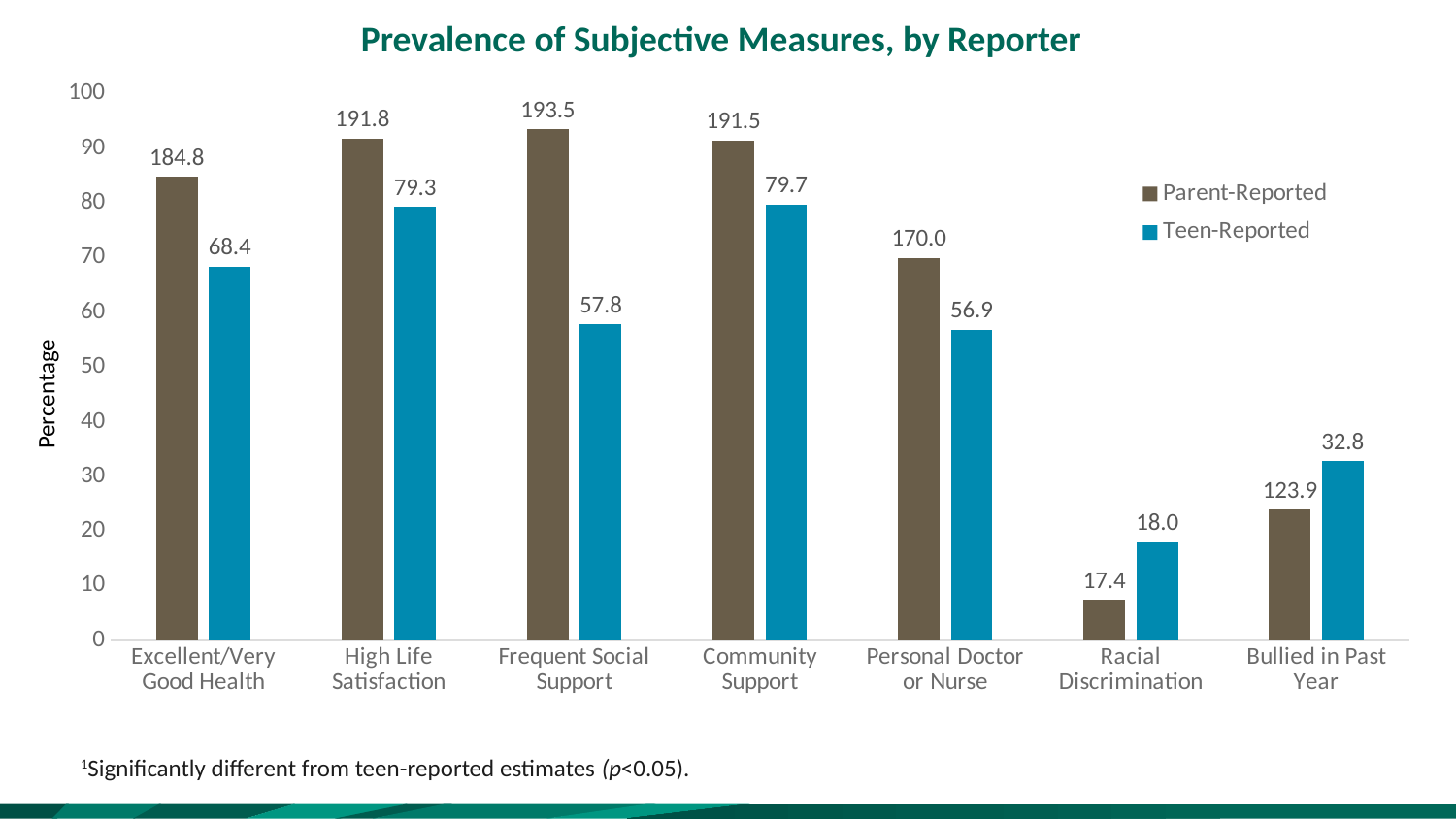
How many series does the legend list? 2 What is the Teen-Reported value for Excellent/Very Good Health? 68.4 What is the difference between the Teen-Reported values for High Life Satisfaction and Excellent/Very Good Health? 10.9 What is the Teen-Reported value for Frequent Social Support? 57.8 For Bullied in Past Year, which is larger: the Parent-Reported or the Teen-Reported value? Teen-Reported What is the Teen-Reported value for Bullied in Past Year? 32.8 Which category has the lowest Teen-Reported value? Racial Discrimination What is the Teen-Reported value for Personal Doctor or Nurse? 56.9 How many categories are shown on the x axis? 7 Is the Parent-Reported value for Community Support greater or less than 80? greater Which category has the lowest Parent-Reported value? Racial Discrimination What kind of chart is shown on the slide? Bar chart